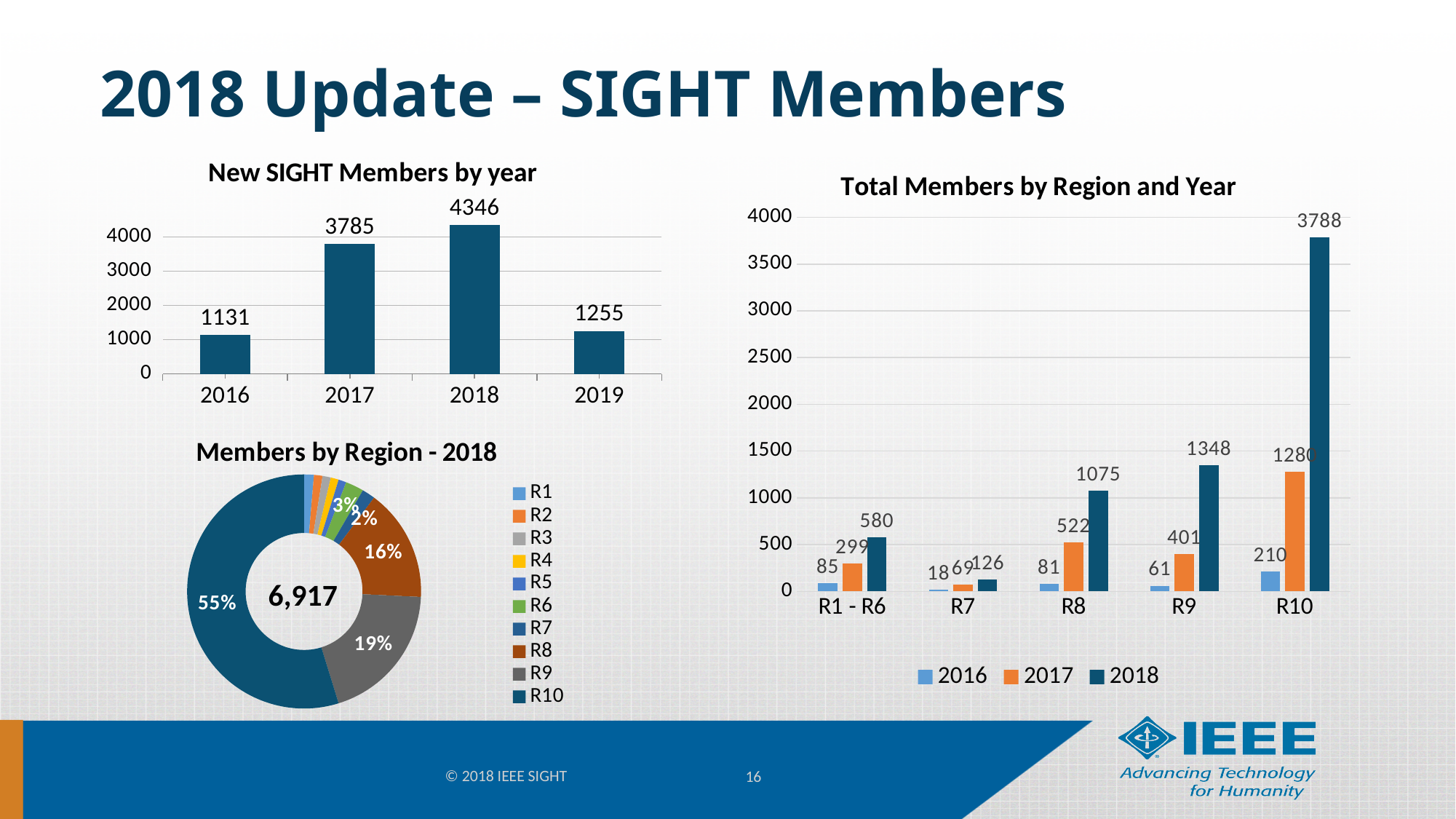
In the 'Total Members by Region and Year' chart, how many series does the legend list? 3 In the 'Total Members by Region and Year' chart, which region has the highest 2018 value? R10 In the 'New SIGHT Members by year' chart, how many years are shown on the x axis? 4 In the 'New SIGHT Members by year' chart, what is the value for 2018? 4346 In the 'Members by Region - 2018' chart, what total is shown in the centre? 6,917 In the 'New SIGHT Members by year' chart, which year has the lowest value? 2016 In the 'Total Members by Region and Year' chart, is the 2018 value for R9 larger or smaller than the 2018 value for R8? larger In the 'Members by Region - 2018' chart, what share does R10 have? 55% What kind of chart is 'Members by Region - 2018'? Doughnut chart In the 'Total Members by Region and Year' chart, what is the 2017 value for R8? 522 In the 'New SIGHT Members by year' chart, what is the difference between the 2018 and 2017 values? 561 In the 'Members by Region - 2018' chart, how many regions does the legend list? 10